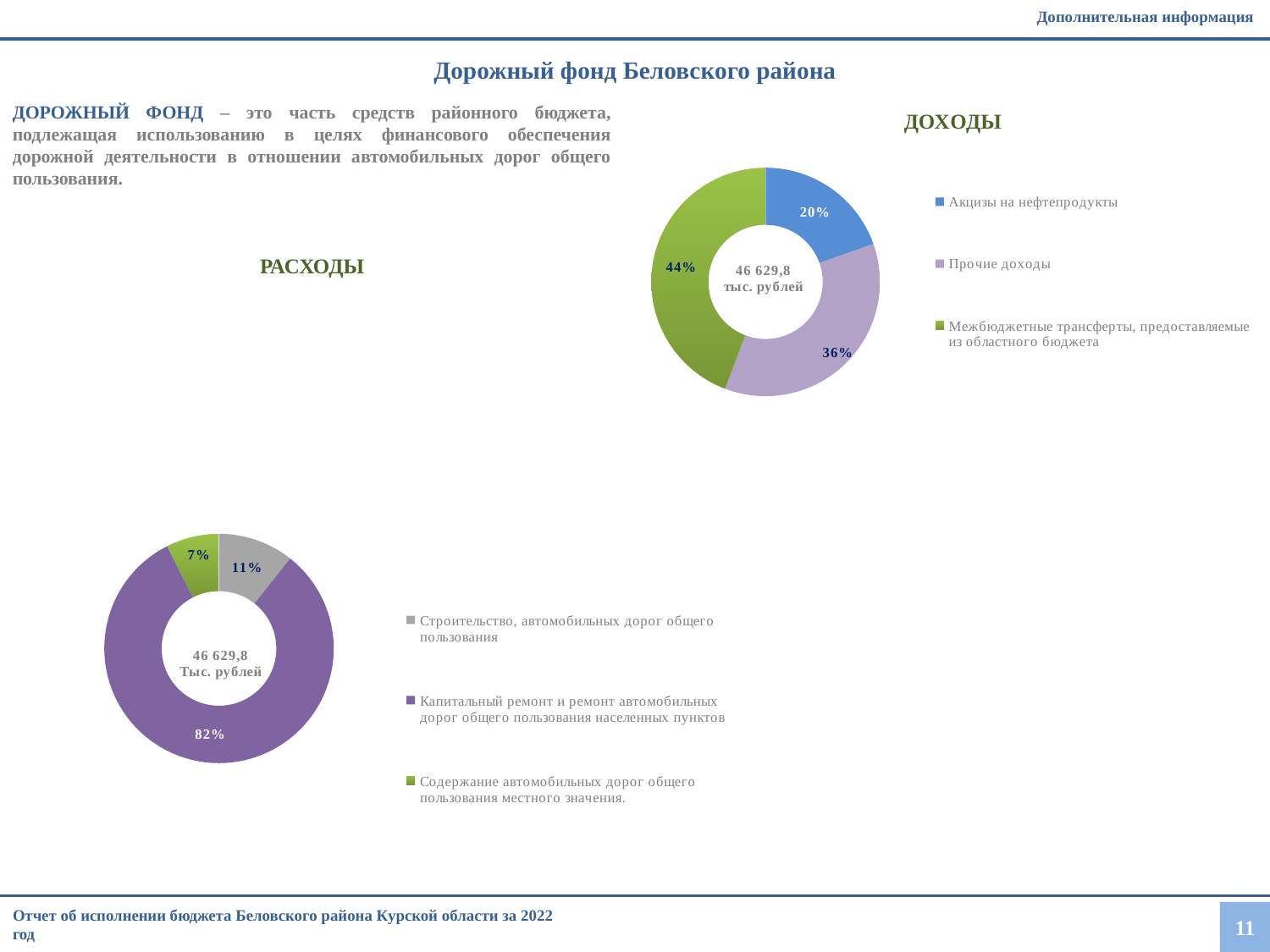
In the РАСХОДЫ chart, what share is labelled for Капитальный ремонт и ремонт автомобильных дорог общего пользования населенных пунктов? 82% In the РАСХОДЫ chart, what share is labelled for Содержание автомобильных дорог общего пользования местного значения? 7% In the ДОХОДЫ chart, what share is labelled for Прочие доходы? 36% What total value is shown in the centre of the ДОХОДЫ chart? 46 629,8 тыс. рублей In the ДОХОДЫ chart, what is the difference in percentage points between Межбюджетные трансферты and Акцизы на нефтепродукты? 24 In the ДОХОДЫ chart, what share is labelled for Акцизы на нефтепродукты? 20% What type of chart is used for ДОХОДЫ? Pie (donut) chart In the РАСХОДЫ chart, which is larger: the share for Строительство автомобильных дорог общего пользования or the share for Содержание автомобильных дорог? Строительство автомобильных дорог общего пользования In the ДОХОДЫ chart, what colour is the slice for Прочие доходы? Purple In the ДОХОДЫ chart, which category has the smallest share? Акцизы на нефтепродукты How many categories does the legend of the РАСХОДЫ chart list? 3 In the ДОХОДЫ chart, which category has the largest share? Межбюджетные трансферты, предоставляемые из областного бюджета